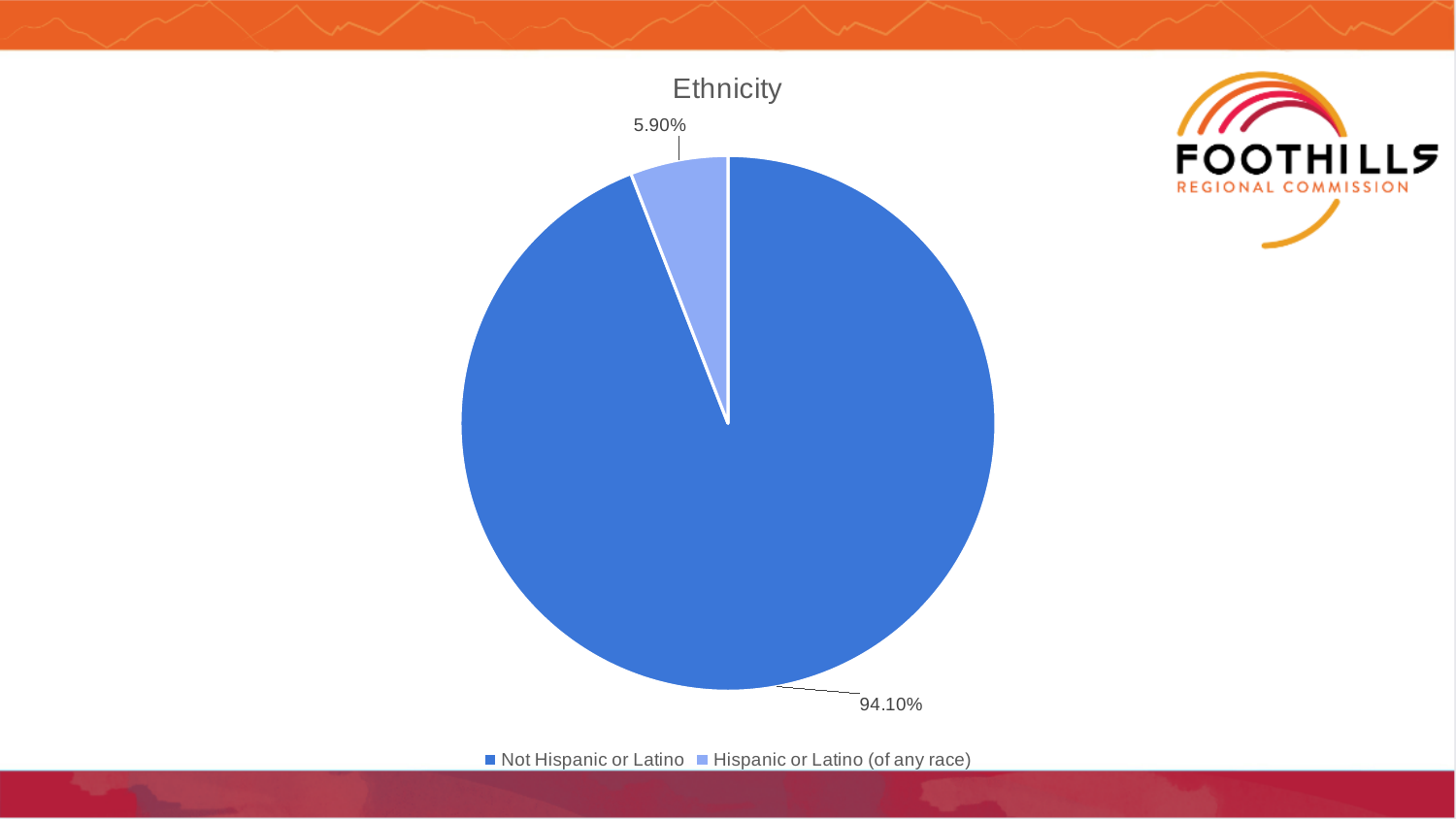
What colour is the slice for Hispanic or Latino (of any race)? light blue Which is larger, the share for Not Hispanic or Latino or the share for Hispanic or Latino (of any race)? Not Hispanic or Latino What percentage of the pie is Not Hispanic or Latino? 94.10% Which category has the smallest share of the pie? Hispanic or Latino (of any race) What is the difference in percentage points between Not Hispanic or Latino and Hispanic or Latino (of any race)? 88.20% How many entries does the legend list? 2 What type of chart is shown on the slide? pie chart What is the title of the chart? Ethnicity How many categories does the pie chart show? 2 Which category has the largest share of the pie? Not Hispanic or Latino What percentage of the pie is Hispanic or Latino (of any race)? 5.90%